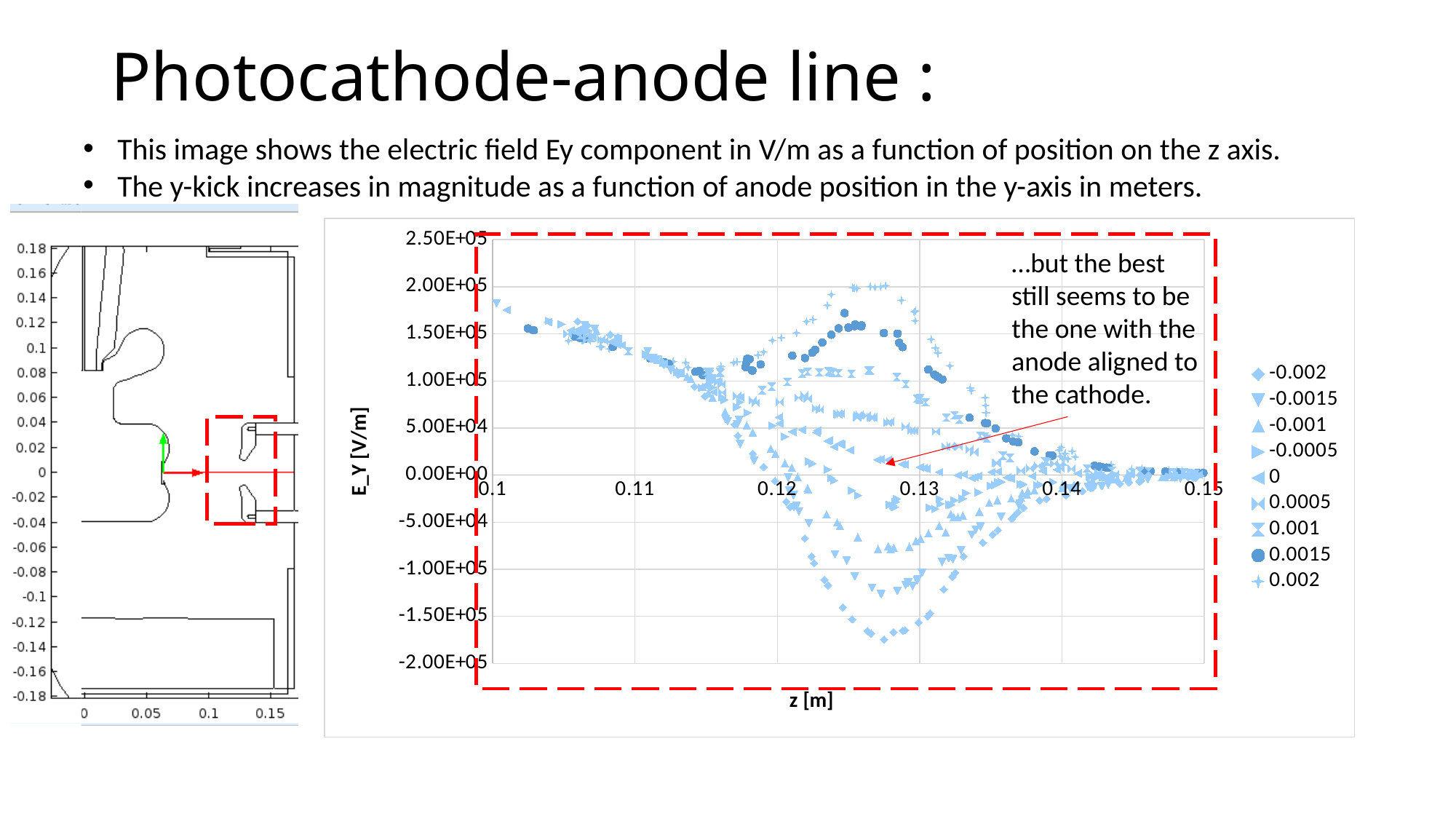
Which series has the larger E_Y value at z = 0.125, 0.0015 or 0? 0.0015 What kind of chart is shown on the slide? scatter chart Which series reaches the lowest E_Y value on the chart? -0.002 Is the value of the 0 series at z = 0.1 greater or less than 1.00E+05? greater Is the highest value of the 0.002 series greater or less than 1.50E+05? greater What is the title of the horizontal axis of the chart? z [m] What is the title of the vertical axis of the chart? E_Y [V/m] Which series has the lower E_Y value near z = 0.125, -0.002 or -0.0015? -0.002 Do the values of the 0.0015 series rise or fall as z increases from 0.13 to 0.15? fall Which series reaches the highest E_Y value on the chart? 0.002 How many series does the chart legend list? 9 Is the lowest value of the -0.002 series greater or less than -1.50E+05? less